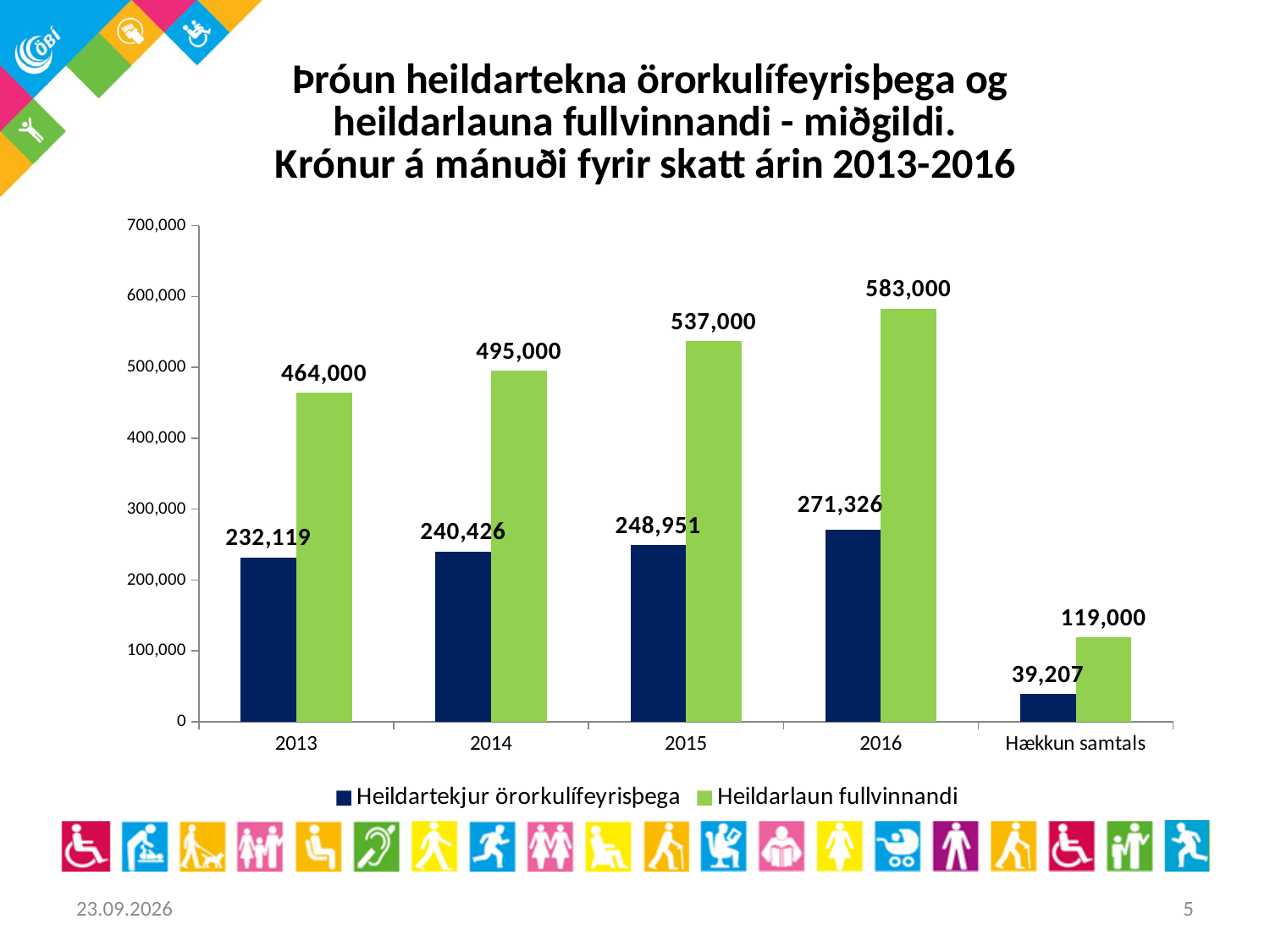
Which year has the highest value for Heildarlaun fullvinnandi? 2016 What is the value for Heildarlaun fullvinnandi in 2014? 495,000 What is the value for Heildarlaun fullvinnandi in 2016? 583,000 How many series does the legend list? 2 Is the value for Heildarlaun fullvinnandi in 2015 greater or less than 500,000? greater Do the values for Heildartekjur örorkulífeyrisþega rise or fall from 2013 to 2016? rise Which is larger in 2015: Heildartekjur örorkulífeyrisþega or Heildarlaun fullvinnandi? Heildarlaun fullvinnandi What is the difference between Heildarlaun fullvinnandi and Heildartekjur örorkulífeyrisþega in 2016? 311,674 What is the value for Heildartekjur örorkulífeyrisþega for Hækkun samtals? 39,207 Which category has the lowest value for Heildartekjur örorkulífeyrisþega? Hækkun samtals What is the value for Heildartekjur örorkulífeyrisþega in 2013? 232,119 How many categories are shown on the x axis? 5